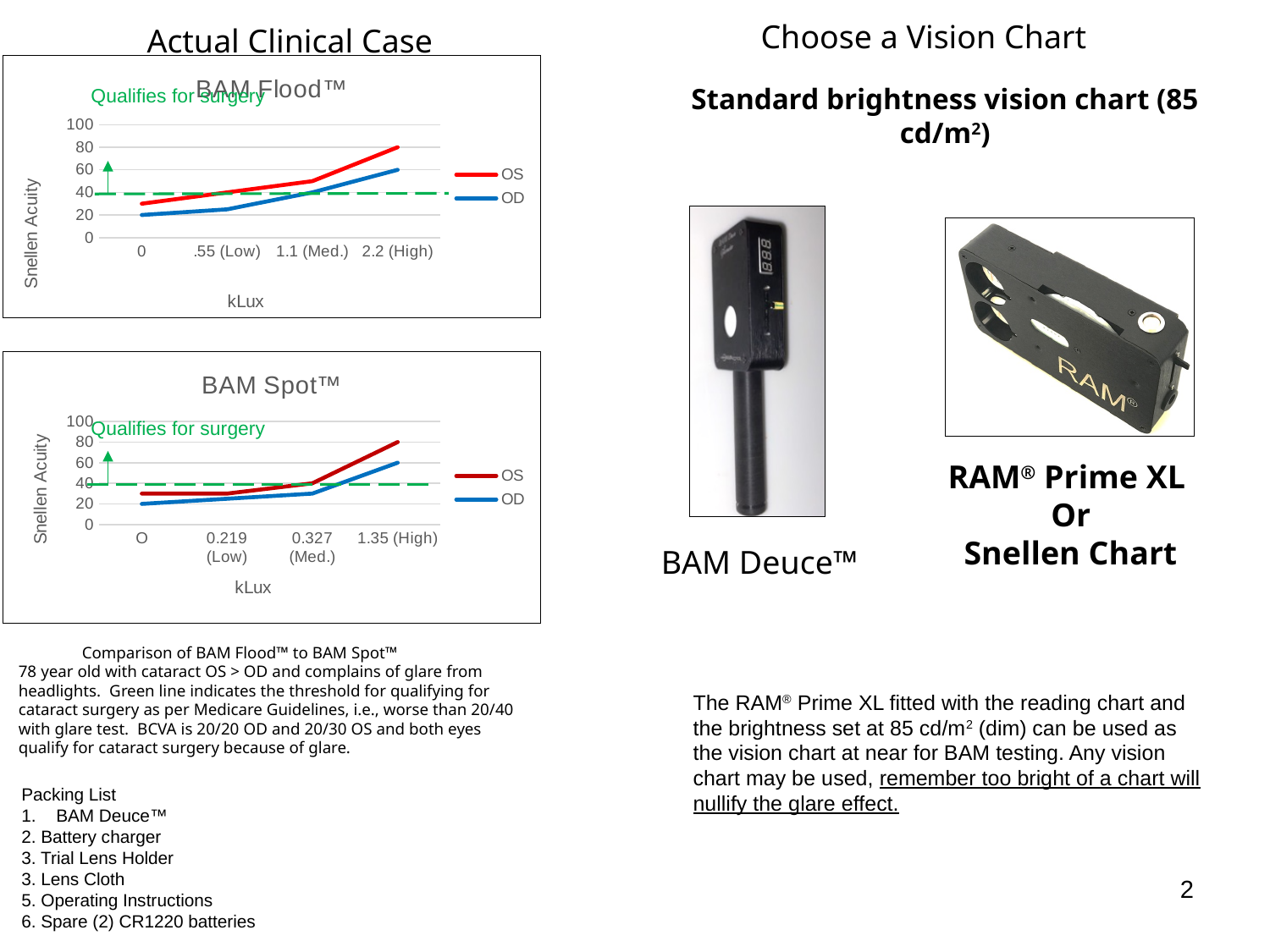
In the BAM Spot™ chart, at which x-axis category is the OD value lowest? O What type of chart is the BAM Flood™ chart? line chart In the BAM Flood™ chart, is the OD value at 0 greater or less than 40? less In the BAM Flood™ chart, at which kLux category is the OS value highest? 2.2 (High) In the BAM Flood™ chart, which series has the larger value at 2.2 (High), OS or OD? OS In the BAM Flood™ chart, is the OS value at 2.2 (High) greater or less than 60? greater In the BAM Spot™ chart, is the OS value at 1.35 (High) greater or less than 60? greater In the BAM Spot™ chart, do the OS values rise or fall as kLux increases along the x axis? rise How many kLux categories are shown on the x axis of the BAM Flood™ chart? 4 How many series does the legend of the BAM Spot™ chart list? 2 What is the y-axis title of the BAM Spot™ chart? Snellen Acuity